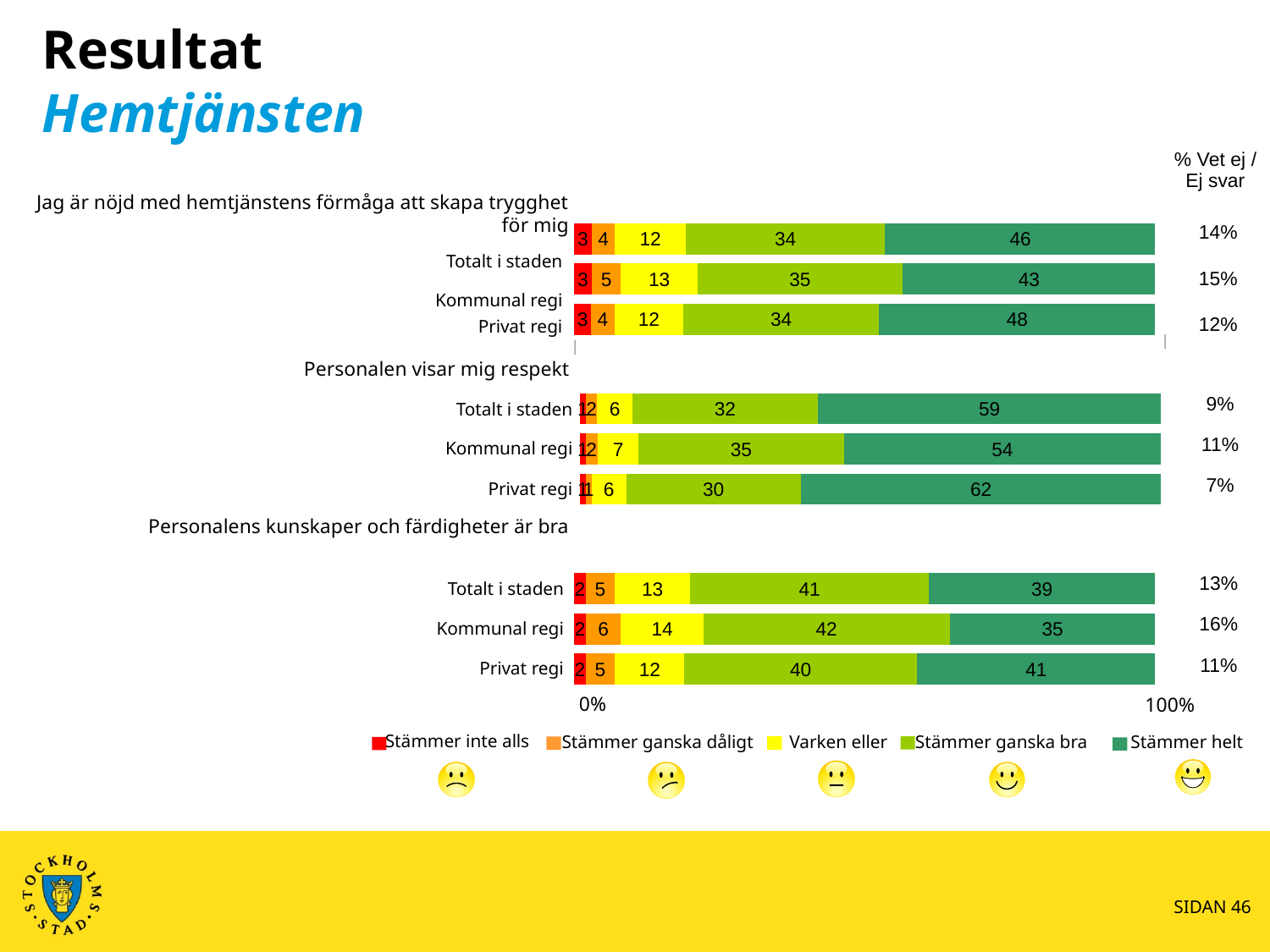
For 'Personalens kunskaper och färdigheter är bra', what is the 'Stämmer ganska bra' value for Kommunal regi? 42 Under 'Personalen visar mig respekt', which row has the highest 'Stämmer helt' value? Privat regi What is the label of the first (red) series in the legend? Stämmer inte alls For 'Personalen visar mig respekt', what is the difference between the 'Stämmer helt' values for Privat regi and Kommunal regi? 8 What kind of chart is shown on the slide? Stacked bar chart Under 'Personalens kunskaper och färdigheter är bra', which row has the lowest 'Stämmer helt' value? Kommunal regi Which '% Vet ej / Ej svar' value is the lowest on the slide? 7% For 'Jag är nöjd med hemtjänstens förmåga att skapa trygghet för mig', what is the 'Stämmer helt' value for Privat regi? 48 How many series does the legend list? 5 For 'Personalen visar mig respekt', what is the 'Stämmer helt' value for Privat regi? 62 What is the '% Vet ej / Ej svar' value for Kommunal regi under 'Personalens kunskaper och färdigheter är bra'? 16% Under 'Jag är nöjd med hemtjänstens förmåga att skapa trygghet för mig', is the 'Stämmer helt' value larger for Totalt i staden or Kommunal regi? Totalt i staden